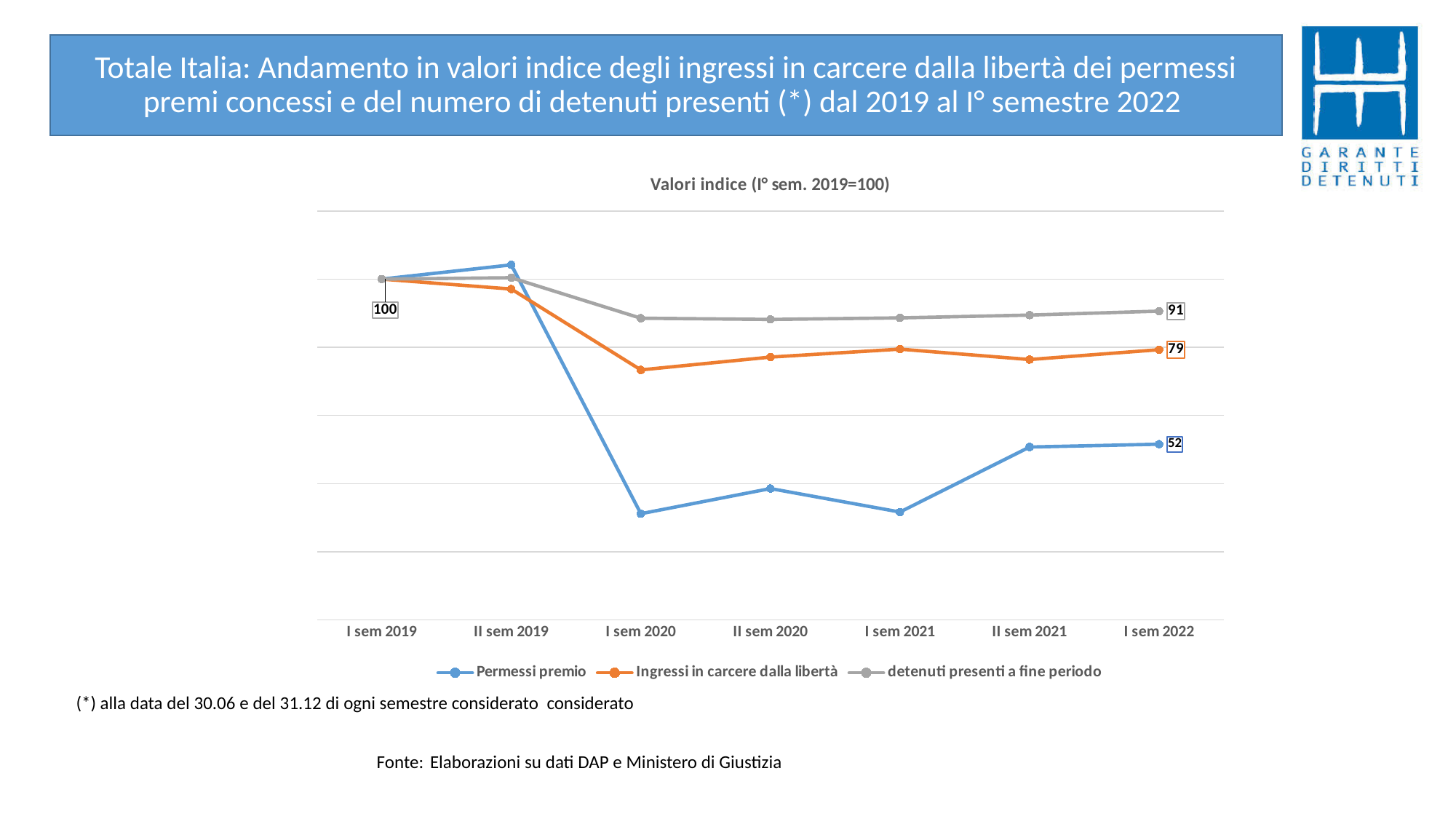
How many series does the legend list? 3 What is the difference between the I sem 2022 values of detenuti presenti a fine periodo and Permessi premio? 39 Which series has the lowest value in I sem 2022? Permessi premio What is the difference between the I sem 2022 values of detenuti presenti a fine periodo and Ingressi in carcere dalla libertà? 12 What is the index value for detenuti presenti a fine periodo in I sem 2022? 91 What is the index value for Permessi premio in I sem 2022? 52 What is the title printed above the chart? Valori indice (I° sem. 2019=100) Does the Permessi premio series rise or fall from I sem 2019 to I sem 2022? fall What is the index value for Ingressi in carcere dalla libertà in I sem 2022? 79 How many periods are shown along the x axis? 7 What is the index value of all series in I sem 2019? 100 What kind of chart is shown on the slide? line chart